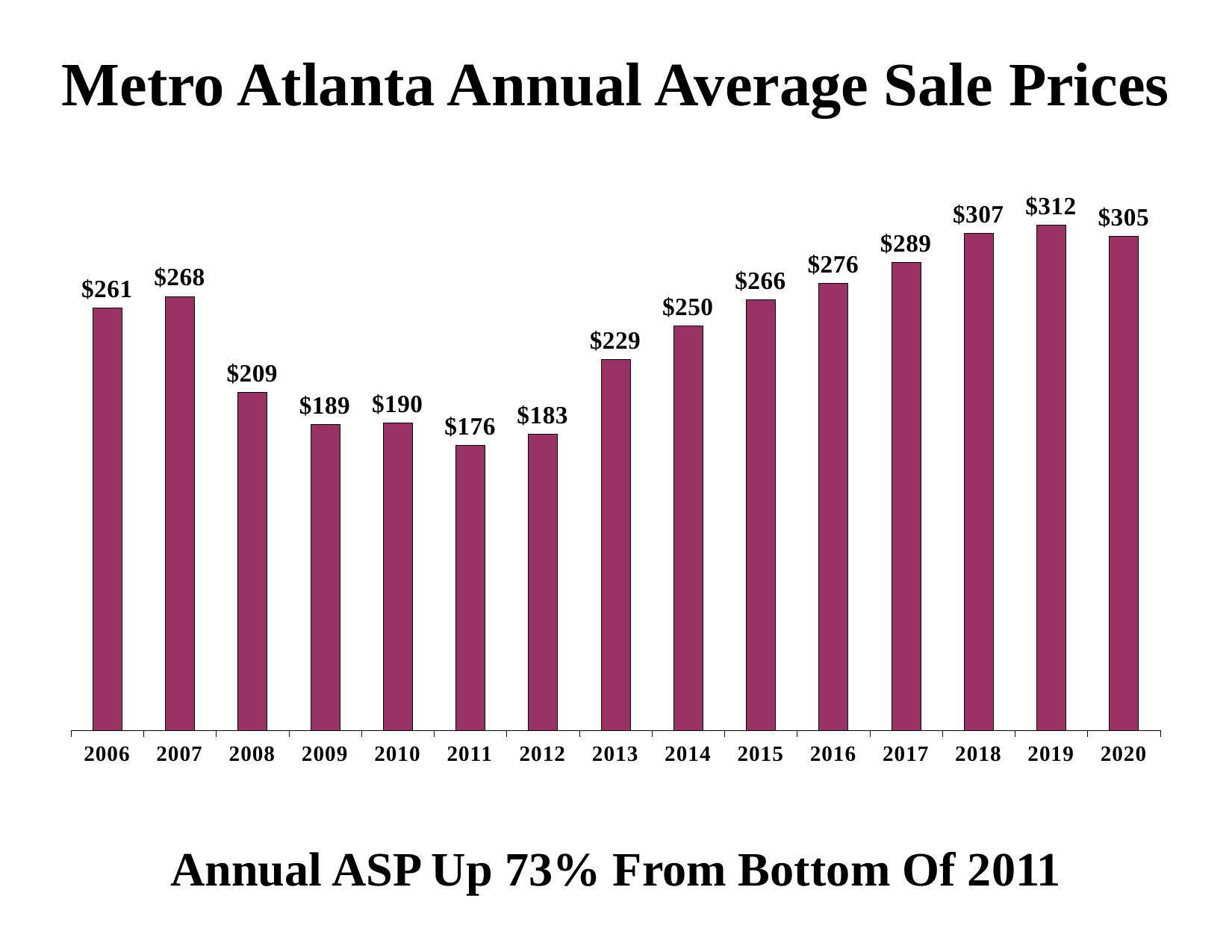
Which year has the highest average sale price? 2019 Which year has the lowest average sale price? 2011 What is the average sale price shown for 2011? $176 What is the average sale price shown for 2006? $261 What kind of chart is shown on the slide? Bar chart What is the title of the chart? Metro Atlanta Annual Average Sale Prices Do the average sale prices rise or fall from 2011 to 2019? Rise What is the difference between the 2020 and 2006 average sale prices? $44 What is the difference between the 2019 and 2011 average sale prices? $136 How many years are shown on the x axis? 15 What is the average sale price shown for 2017? $289 Which year has a higher average sale price, 2008 or 2013? 2013